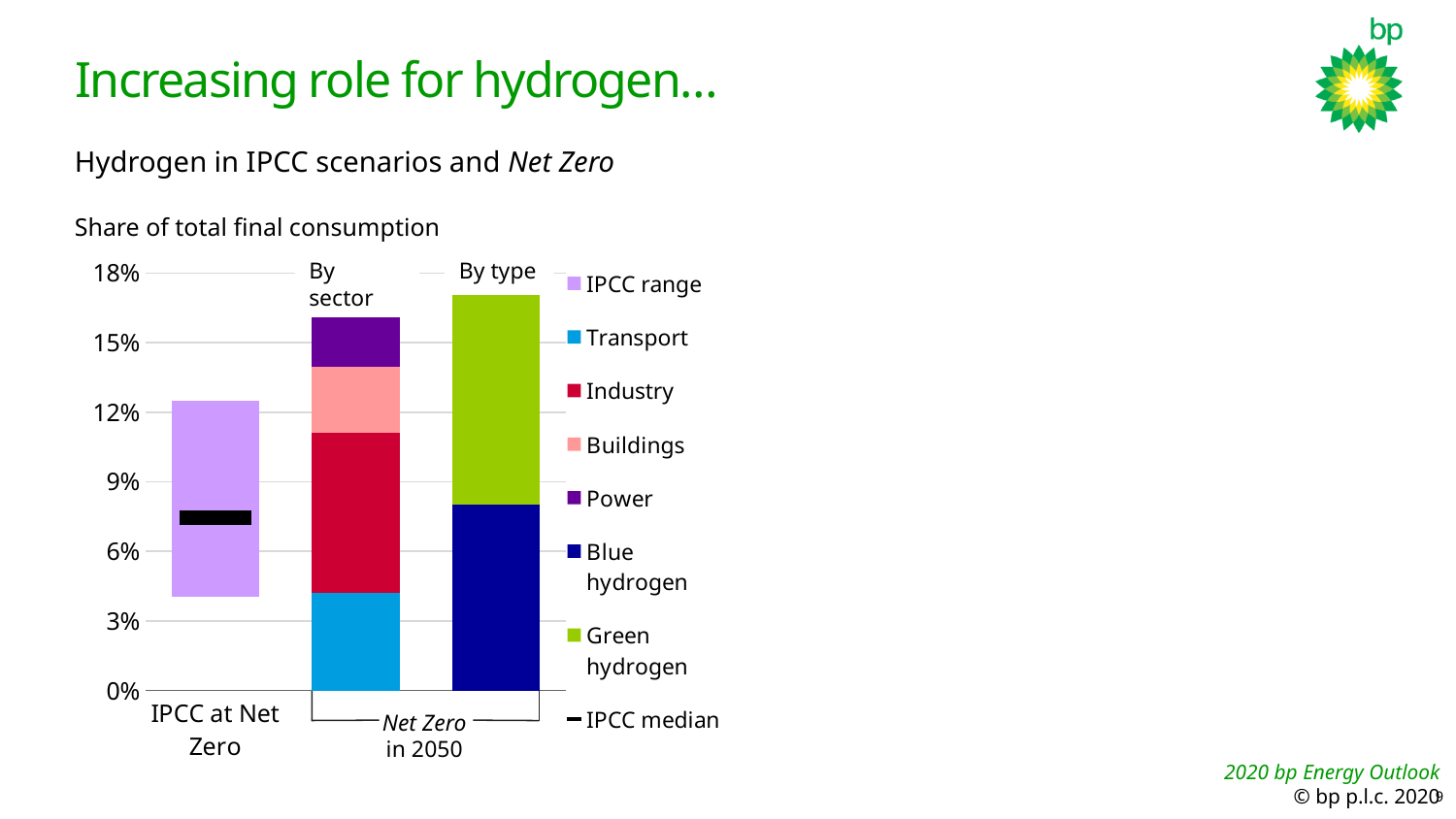
Is the total of the 'By sector' bar for Net Zero in 2050 greater or less than 15%? greater What is the y-axis label of the chart? Share of total final consumption Which colour represents Green hydrogen in the legend? green Is the Blue hydrogen segment in the 'By type' bar greater or less than 9%? less Which segment is larger in the 'By sector' bar, Industry or Buildings? Industry How many entries does the chart legend list? 8 Is the IPCC median value for IPCC at Net Zero greater or less than 6%? greater Which bar is taller, 'By sector' or 'By type' for Net Zero in 2050? By type How many bars are plotted in the chart? 3 What kind of chart is shown on the slide? bar chart